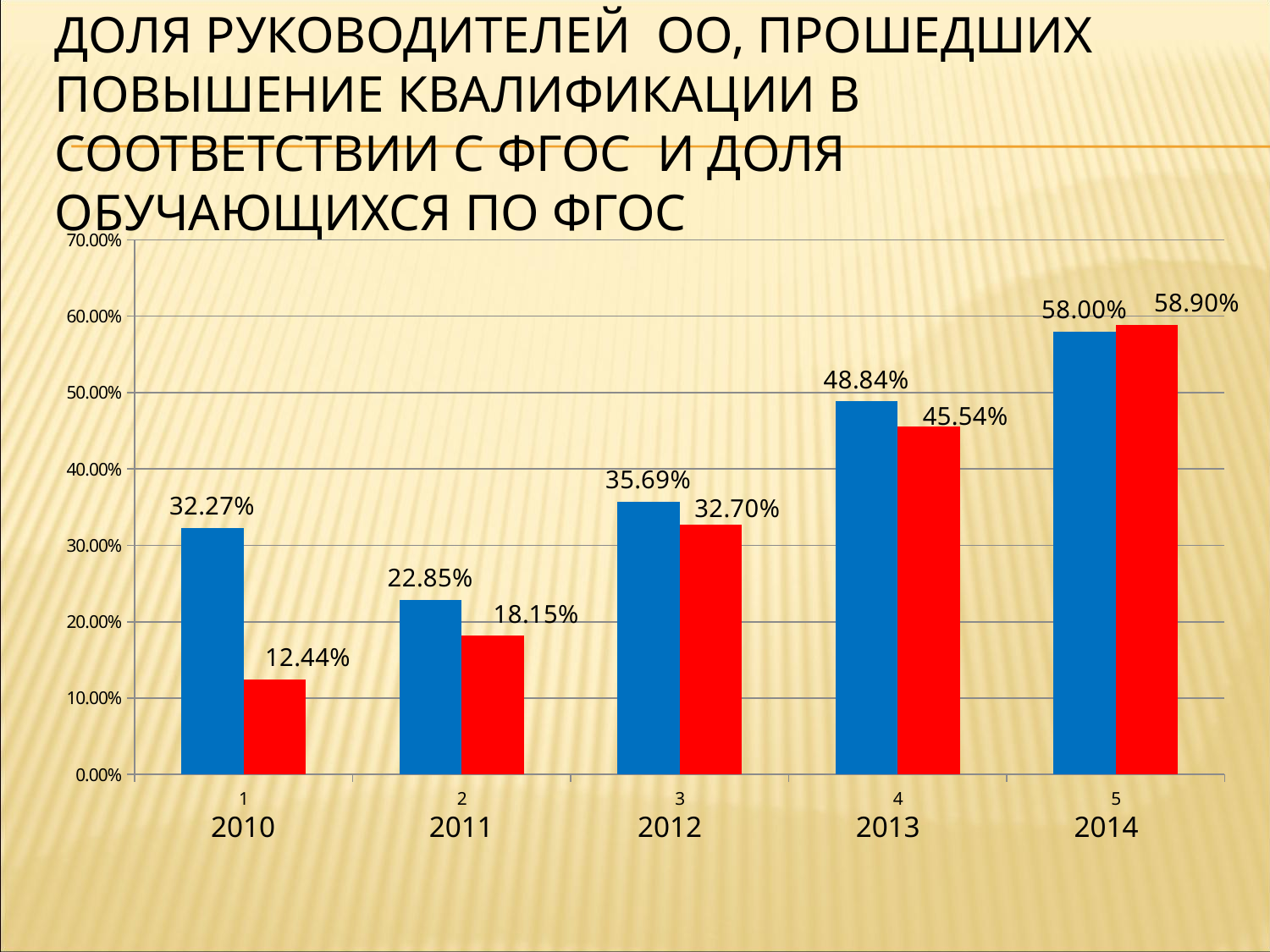
What is the value of the blue bar for 2013? 48.84% Do the red bars rise or fall from 2010 to 2014? rise In which year is the red bar the lowest? 2010 In which year is the red bar the highest? 2014 Is the value of the red bar for 2013 greater or less than 40.00%? greater What is the difference between the blue bar and the red bar for 2010? 19.83% How many years are shown on the x axis? 5 Which bar is larger for 2012, the blue one or the red one? the blue one What is the value of the red bar for 2011? 18.15% What is the value of the blue bar for 2010? 32.27% What kind of chart is shown on the slide? bar chart In which year is the blue bar the lowest? 2011